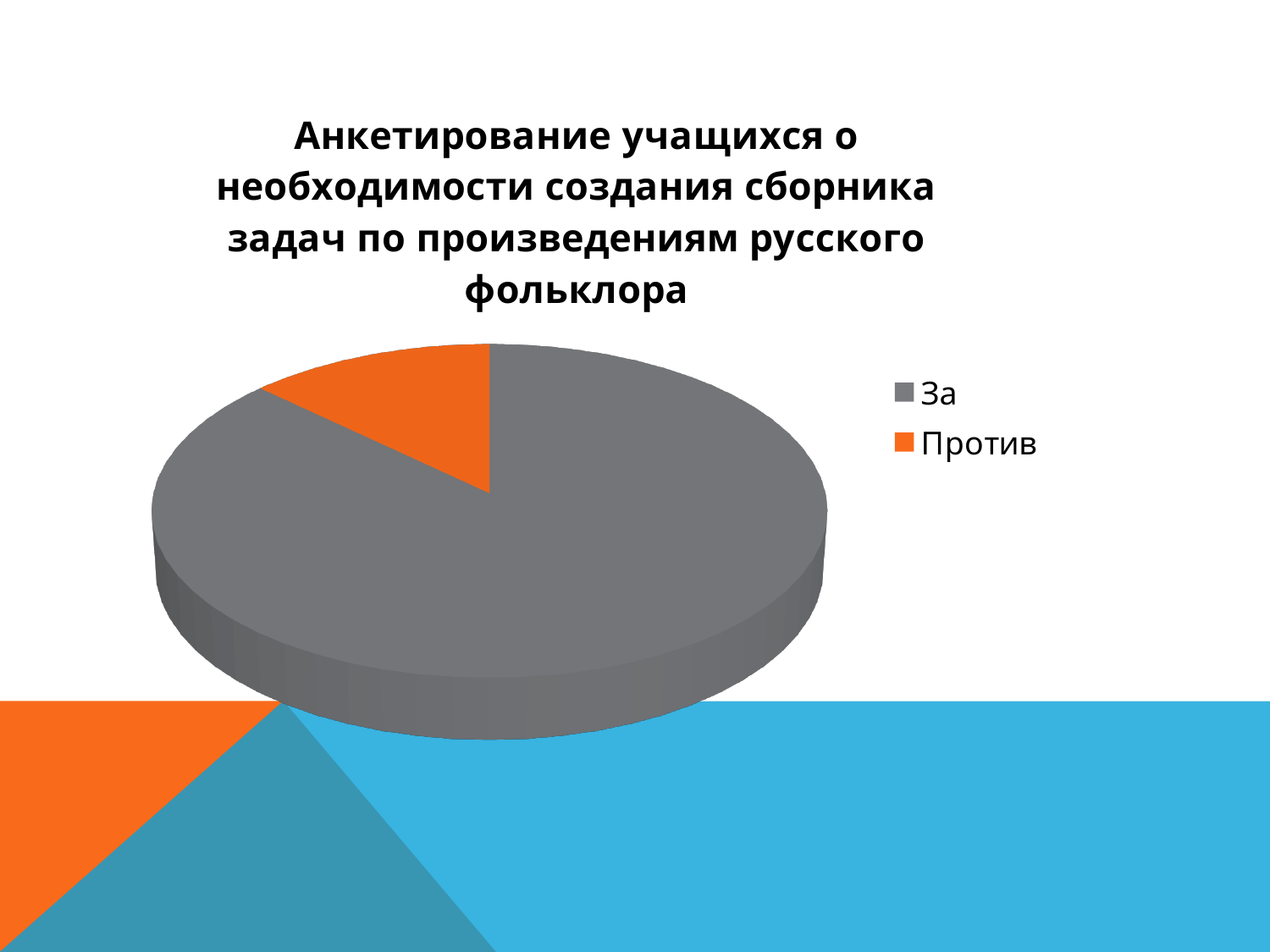
Which category has the largest slice of the pie? За Which category has the smallest slice of the pie? Против What is the title of the chart? Анкетирование учащихся о необходимости создания сборника задач по произведениям русского фольклора What colour is the slice for Против? orange Which slice is larger, За or Против? За What kind of chart is shown on the slide? pie chart How many categories does the pie chart show? 2